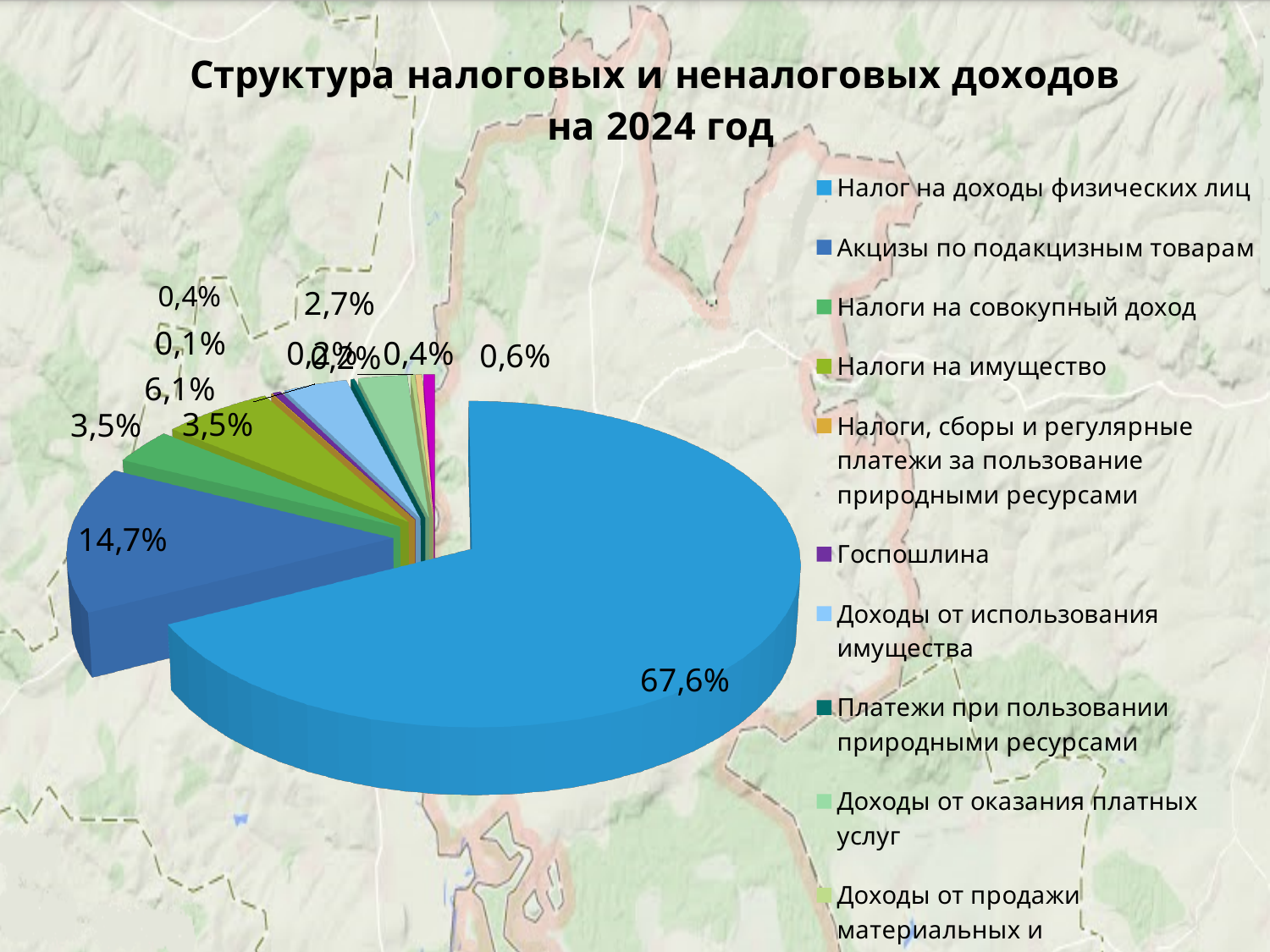
What share of the pie does Налог на доходы физических лиц have? 67,6% How many slices are labelled with percentages on the pie? 12 Is the share for Налог на доходы физических лиц greater or less than 50%? greater What colour is the slice for Налог на доходы физических лиц? Light blue Which is larger: the share for Налог на доходы физических лиц or the share for Акцизы по подакцизным товарам? Налог на доходы физических лиц What is the difference in percentage points between the share for Налог на доходы физических лиц and the share for Акцизы по подакцизным товарам? 52,9 Which category has the largest share of the pie? Налог на доходы физических лиц What type of chart is shown on the slide? Pie chart What share of the pie does Акцизы по подакцизным товарам have? 14,7% What is the title of the chart? Структура налоговых и неналоговых доходов на 2024 год What is the smallest percentage value labelled on the pie? 0,1%